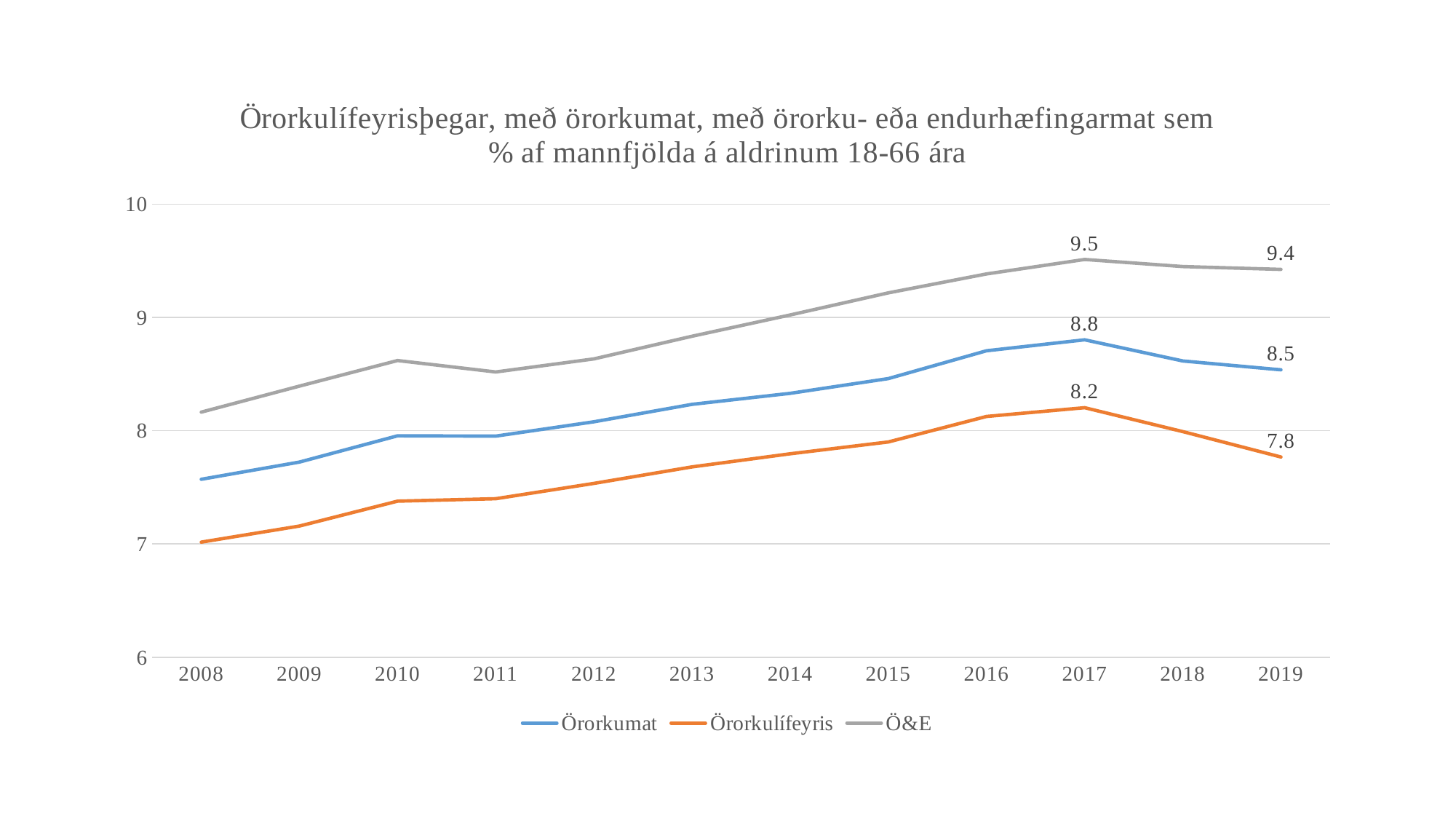
What kind of chart is shown on the slide? line chart What is the value of the Örorkumat series in 2019? 8.5 What is the value of the Ö&E series in 2017? 9.5 What is the difference between the Ö&E value in 2017 and in 2019? 0.1 What is the value of the Örorkulífeyris series in 2017? 8.2 What is the difference between the Örorkumat and Örorkulífeyris values in 2019? 0.7 How many years are shown on the x axis? 12 Is the Örorkulífeyris value in 2008 greater or less than 8? less What is the value of the Örorkulífeyris series in 2019? 7.8 How many series does the legend list? 3 Which series has the highest value in 2017? Ö&E Which series has the lowest value in 2019? Örorkulífeyris